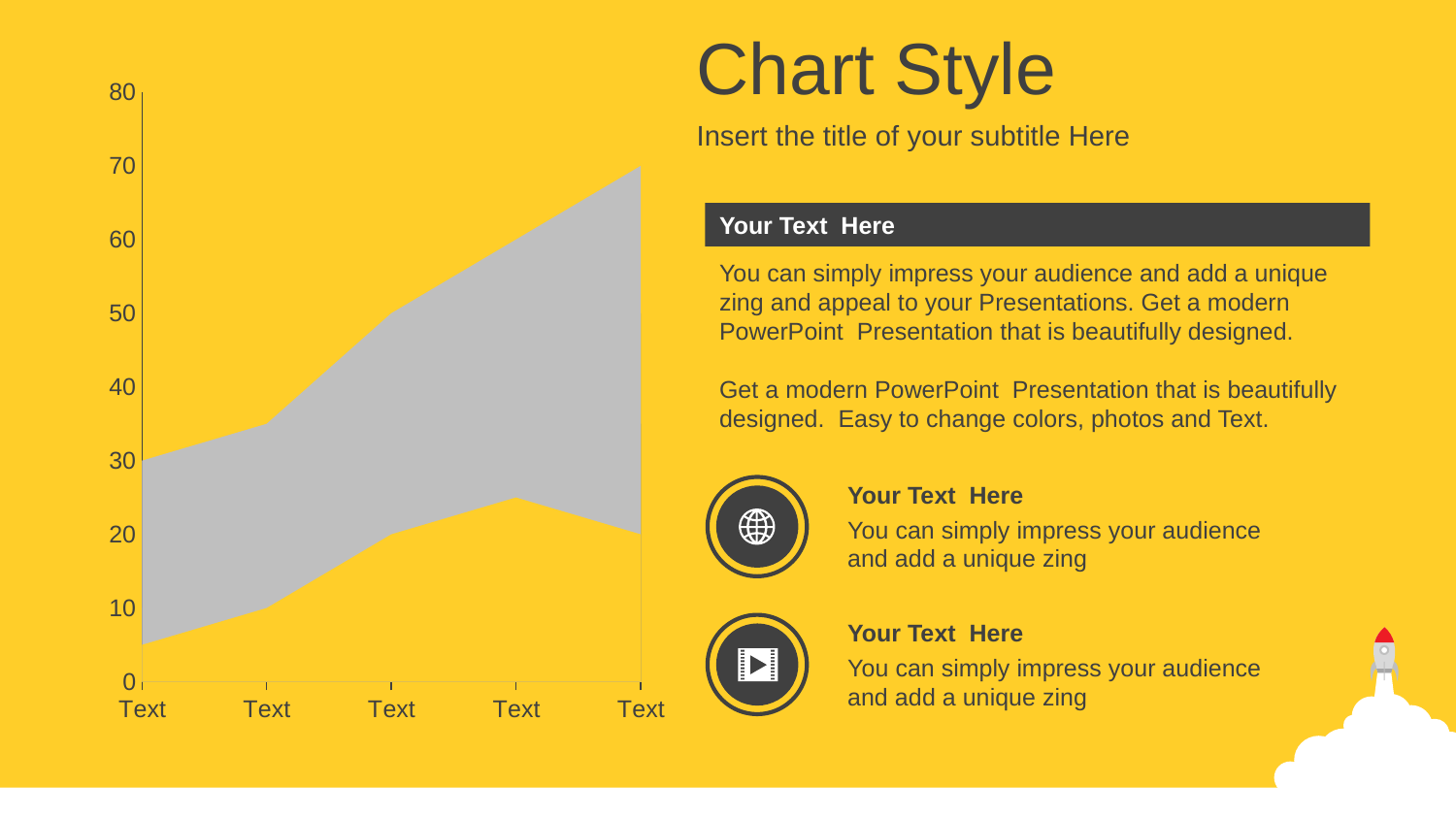
Does the upper edge of the shaded area rise or fall from left to right along the x axis? rise What kind of chart is shown on the slide? area chart Is the upper edge of the shaded area at the last (fifth) category greater or less than 60? greater Is the upper edge of the shaded area at the first category greater or less than 40? less Which is higher: the upper edge of the shaded area at the first category or at the last category? the last category How many categories are shown along the x axis of the chart? 5 Is the lower edge of the shaded area at the first category greater or less than 10? less What is the highest value shown on the y axis of the chart? 80 At which category does the upper edge of the shaded area reach its highest point? the last (fifth) category What label is used for each category on the x axis of the chart? Text